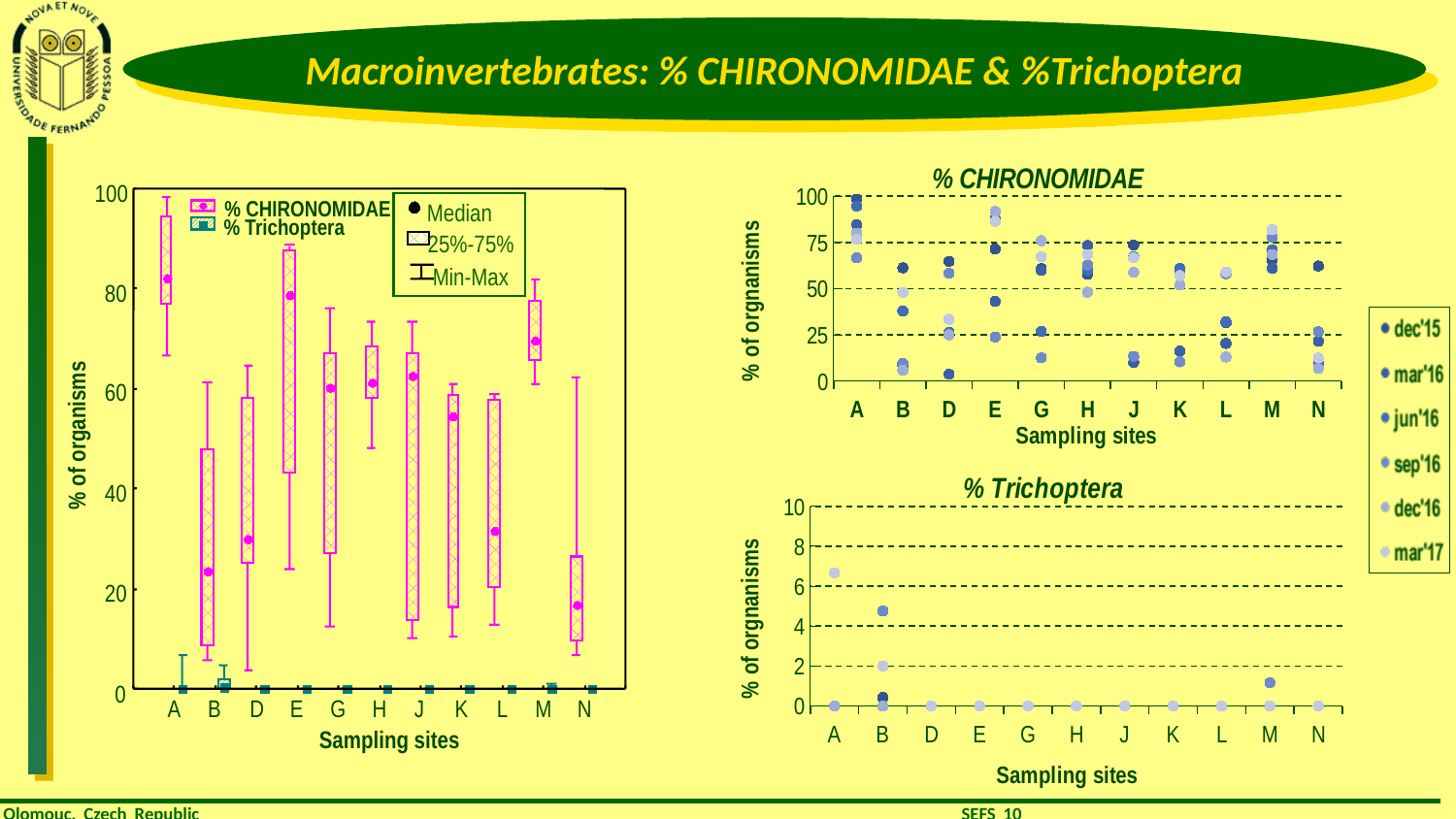
On the left chart, is the median % CHIRONOMIDAE for site A greater or less than 80? greater On the left chart, is the median % CHIRONOMIDAE for site B greater or less than 40? less On the left chart, what does the filled circle in the legend represent? Median On the % Trichoptera chart at the bottom right, which sampling site has the highest plotted value? A On the left chart, how many sampling sites are shown on the x axis? 11 On the left chart, how many series does the legend list? 2 What kind of chart is the left chart? Box plot On the left chart, is the median % CHIRONOMIDAE for site N greater or less than 20? less On the % CHIRONOMIDAE chart at the top right, how many sampling sites are shown on the x axis? 11 On the % CHIRONOMIDAE chart at the top right, how many sampling dates does the legend list? 6